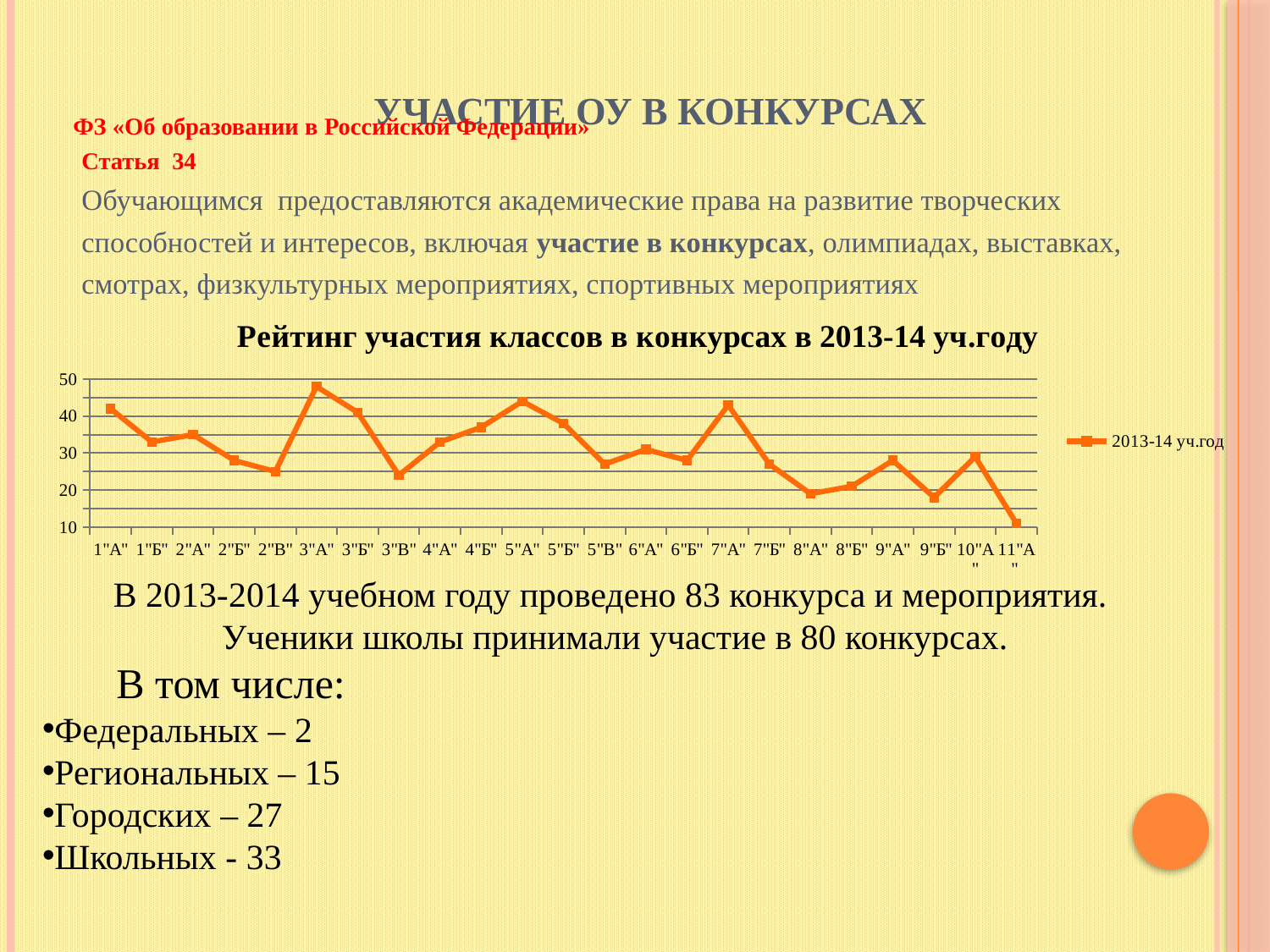
Which class has the lowest value in the chart? 11"А" Is the value for 1"А" greater or less than 40? greater Which class has the larger value, 8"А" or 7"А"? 7"А" How many series does the chart legend list? 1 Which class has the highest value in the chart? 3"А" Is the value for 3"В" greater or less than 30? less What kind of chart is shown on the slide? line chart Is the value for 5"А" greater or less than 40? greater What is the title of the chart? Рейтинг участия классов в конкурсах в 2013-14 уч.году How many classes (categories) are plotted along the x axis of the chart? 23 Which class has the larger value, 1"А" or 2"Б"? 1"А"